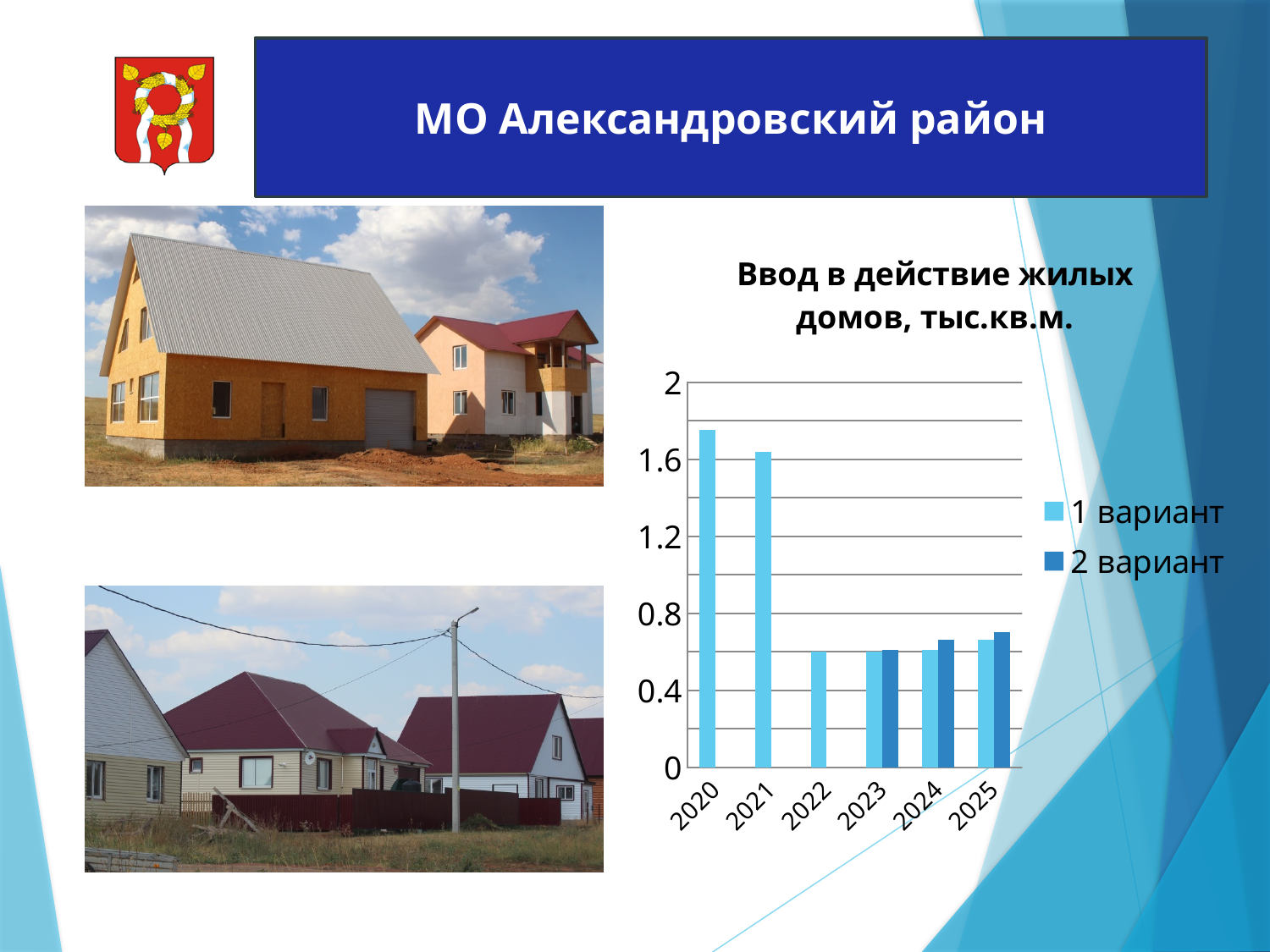
How many series does the chart legend list? 2 What kind of chart is shown on the slide? bar chart What is the title of the chart? Ввод в действие жилых домов, тыс.кв.м. Which is larger for 1 вариант: the value in 2020 or the value in 2025? 2020 What are the two series named in the chart legend? 1 вариант and 2 вариант Is the value for 1 вариант in 2021 greater or less than 1.2? greater How many years are shown on the x axis of the chart? 6 Is the value for 1 вариант in 2020 greater or less than 1.6? greater Do the values for 1 вариант rise or fall from 2020 to 2022? fall Is the value for 1 вариант in 2022 greater or less than 0.8? less In which year is the value for 1 вариант the highest? 2020